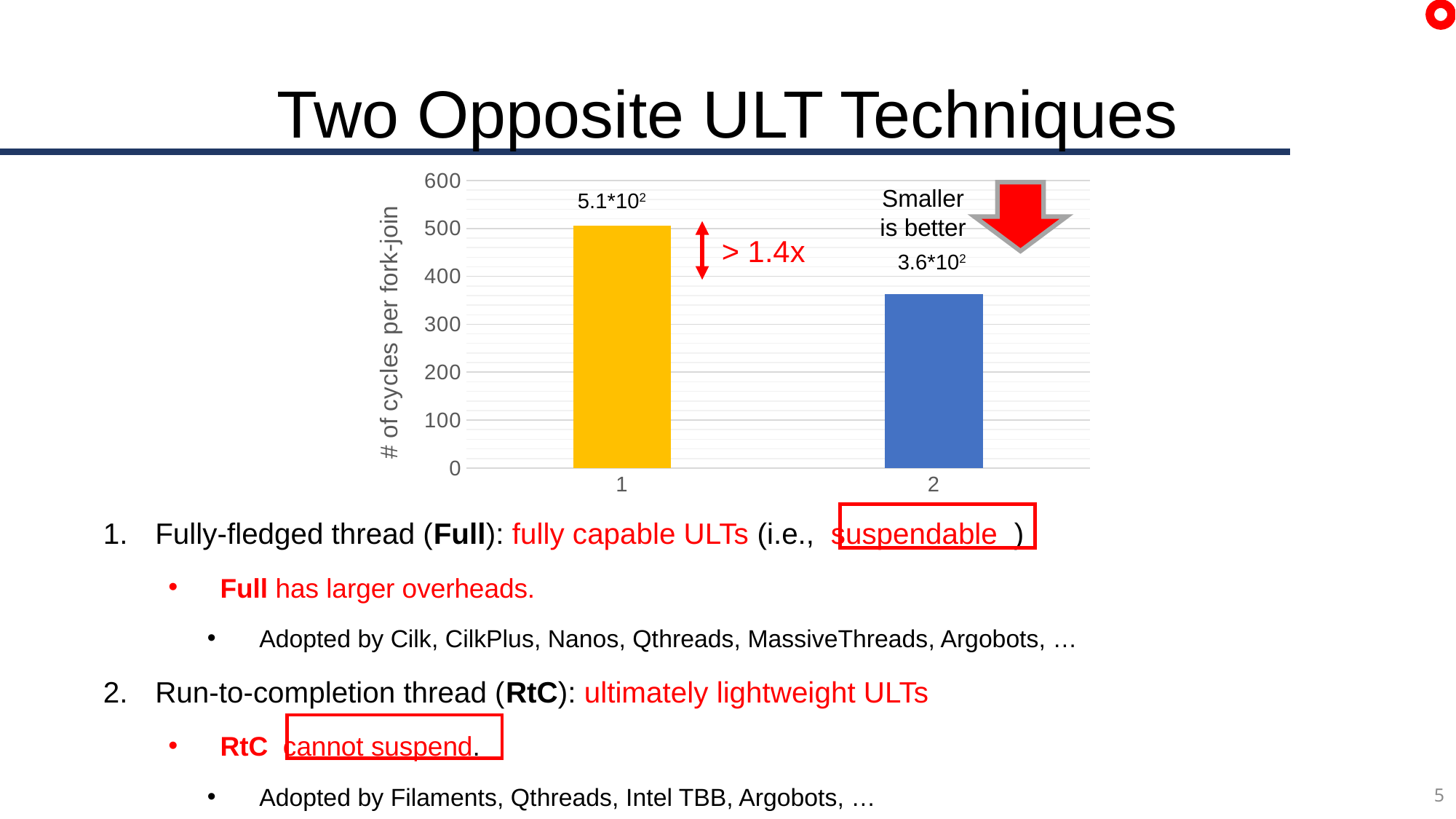
What is the label of the vertical axis? # of cycles per fork-join Is the value for category 2 greater or less than 300? greater Is the value for category 1 larger or smaller than the value for category 2? larger Is the value for category 1 greater or less than 400? greater What is the value shown for category 2? 3.6*10² What is the highest tick value shown on the vertical axis? 600 What is the value shown for category 1? 5.1*10² Which category has the higher number of cycles per fork-join? 1 How many bars are plotted in the chart? 2 What type of chart is shown on the slide? bar chart Is the value for category 2 greater or less than 400? less Which category has the lower number of cycles per fork-join? 2